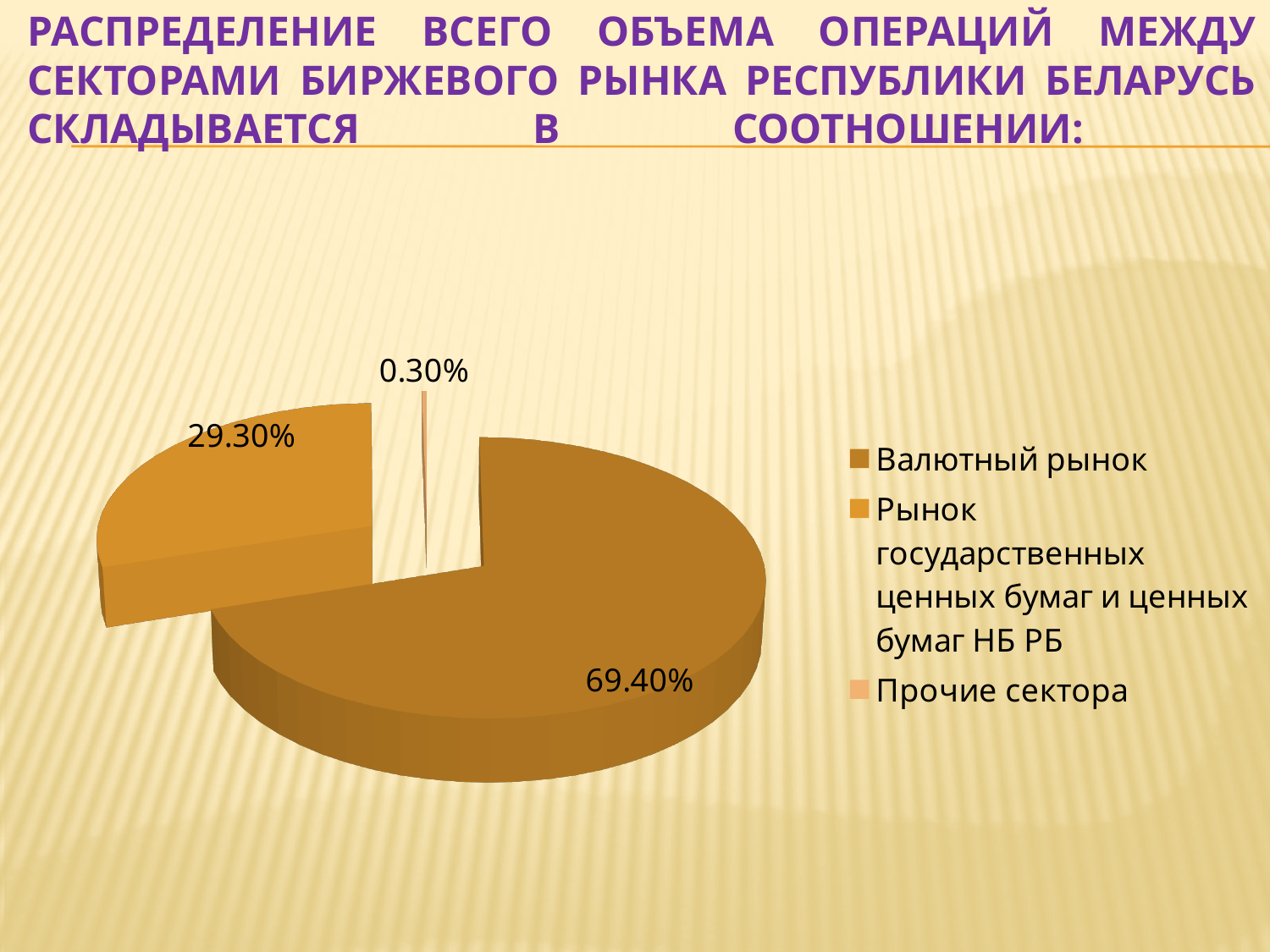
What share of the pie does Прочие сектора have? 0.30% What share of the pie does Рынок государственных ценных бумаг и ценных бумаг НБ РБ have? 29.30% What is the difference in percentage points between Валютный рынок and Рынок государственных ценных бумаг и ценных бумаг НБ РБ? 40.10 What share of the pie does Валютный рынок have? 69.40% How many entries does the legend list? 3 How many slices does the pie chart have? 3 Which sector has the smallest slice of the pie? Прочие сектора What kind of chart is shown on the slide? pie chart Which legend entry is listed first? Валютный рынок Which is larger: the share of Рынок государственных ценных бумаг и ценных бумаг НБ РБ or the share of Прочие сектора? Рынок государственных ценных бумаг и ценных бумаг НБ РБ Which sector has the largest slice of the pie? Валютный рынок Is the share of Валютный рынок greater or less than 50%? greater